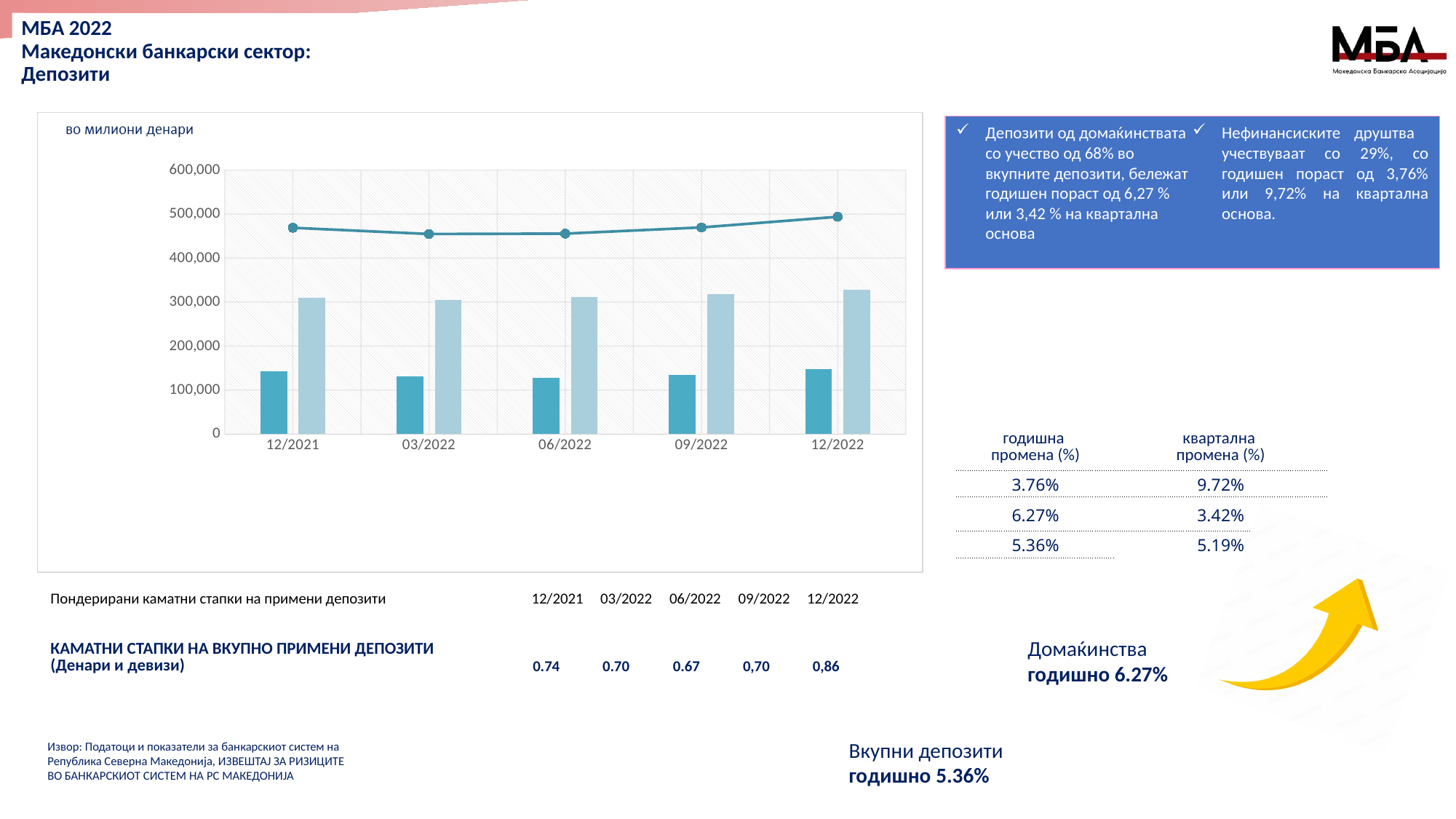
In which period is the light blue bar the tallest? 12/2022 Does the line series rise or fall between 09/2022 and 12/2022? Rises Is the value of the dark teal bar at 12/2021 greater or less than 200,000? less Is the value of the light blue bar at 06/2022 greater or less than 200,000? greater What is the first period shown on the x axis of the chart? 12/2021 At 09/2022, which is larger: the dark teal bar or the light blue bar? The light blue bar What kind of chart is shown on the slide? A combination chart with bars and a line How many time periods are shown on the x axis of the chart? 5 In which period does the line series reach its highest value? 12/2022 What unit label is printed at the top of the chart? во милиони денари Is the value of the line series at 12/2022 greater or less than 400,000? greater